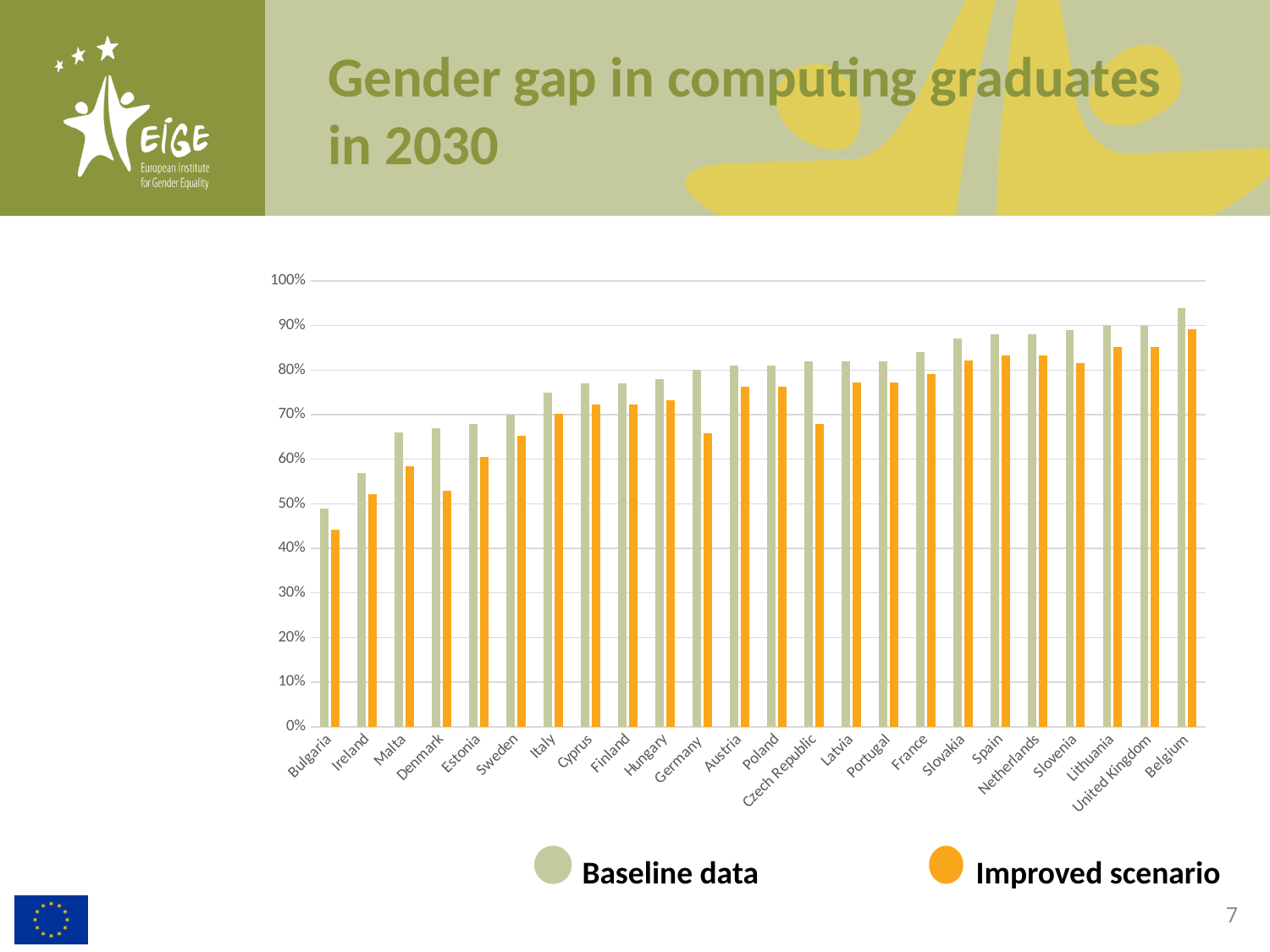
Which country has the lowest Baseline data value? Bulgaria Is the Baseline data value for Belgium greater or less than 90%? greater How many series does the legend list? 2 How many countries are shown on the x axis? 24 Which country has the lowest Improved scenario value? Bulgaria What kind of chart is shown on the slide? Bar chart Which is larger, the Improved scenario value for Germany or for Austria? Austria Is the Improved scenario value for Bulgaria greater or less than 50%? less Which is larger, the Improved scenario value for Czech Republic or for Latvia? Latvia Do the Baseline data values generally rise or fall from left to right along the x axis? Rise Which country has the highest Baseline data value? Belgium Is the Baseline data value for Ireland greater or less than 50%? greater